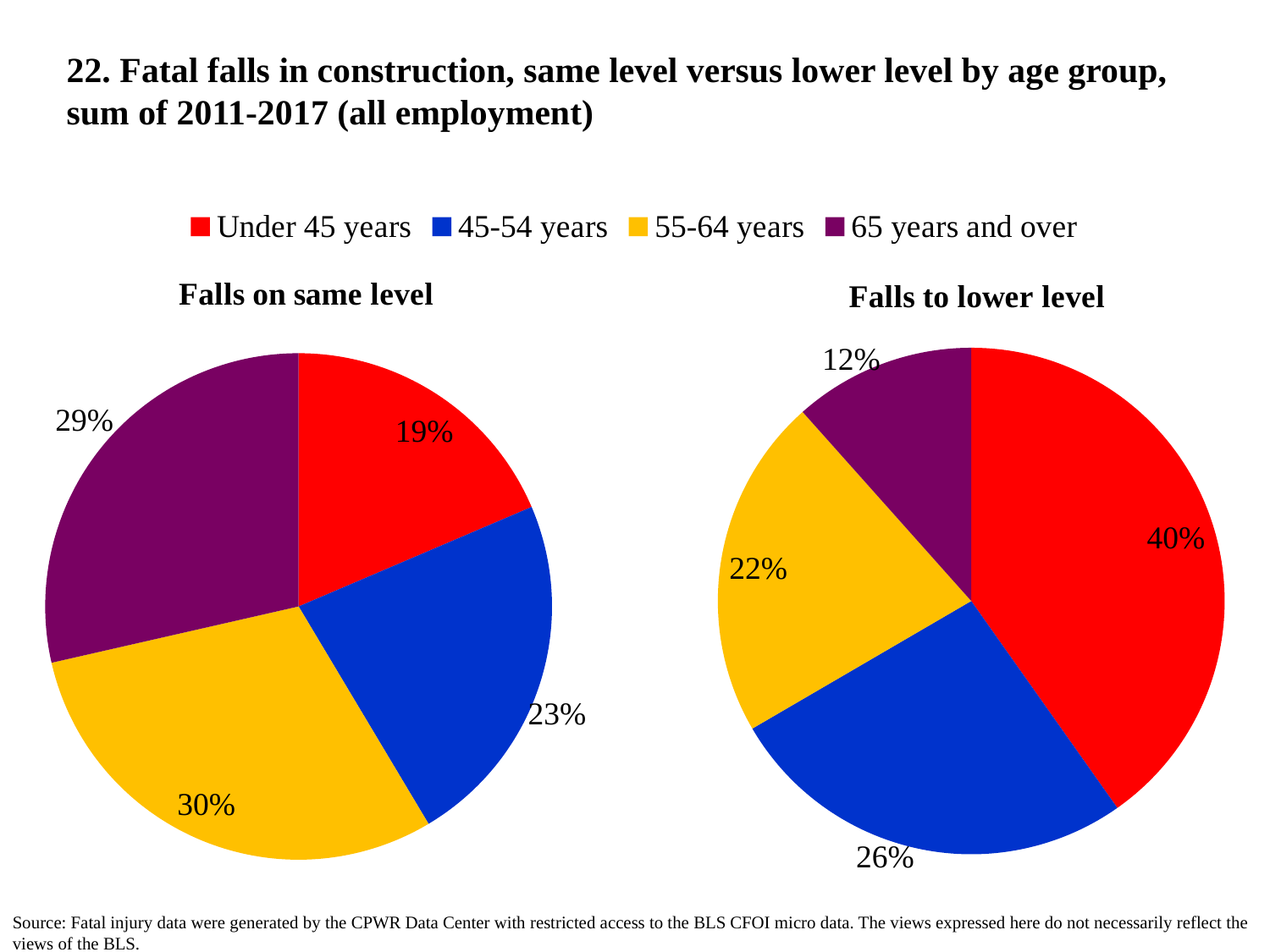
In the 'Falls on same level' pie chart, which is larger: the share for 45-54 years or the share for 55-64 years? 55-64 years What type of chart is used for 'Falls on same level'? Pie chart In the 'Falls on same level' pie chart, what share is shown for the 55-64 years group? 30% Which colour represents the 65 years and over group in the legend? Purple In the 'Falls to lower level' pie chart, which age group has the largest share? Under 45 years In the 'Falls on same level' pie chart, which age group has the smallest share? Under 45 years How many age groups does the legend list? 4 In the 'Falls on same level' pie chart, what share is shown for the 65 years and over group? 29% What is the difference between the Under 45 years share in the 'Falls to lower level' chart and the Under 45 years share in the 'Falls on same level' chart? 21 percentage points In the 'Falls to lower level' pie chart, which age group has the smallest share? 65 years and over In the 'Falls to lower level' pie chart, what share is shown for the Under 45 years group? 40% In the 'Falls to lower level' pie chart, what share is shown for the 45-54 years group? 26%